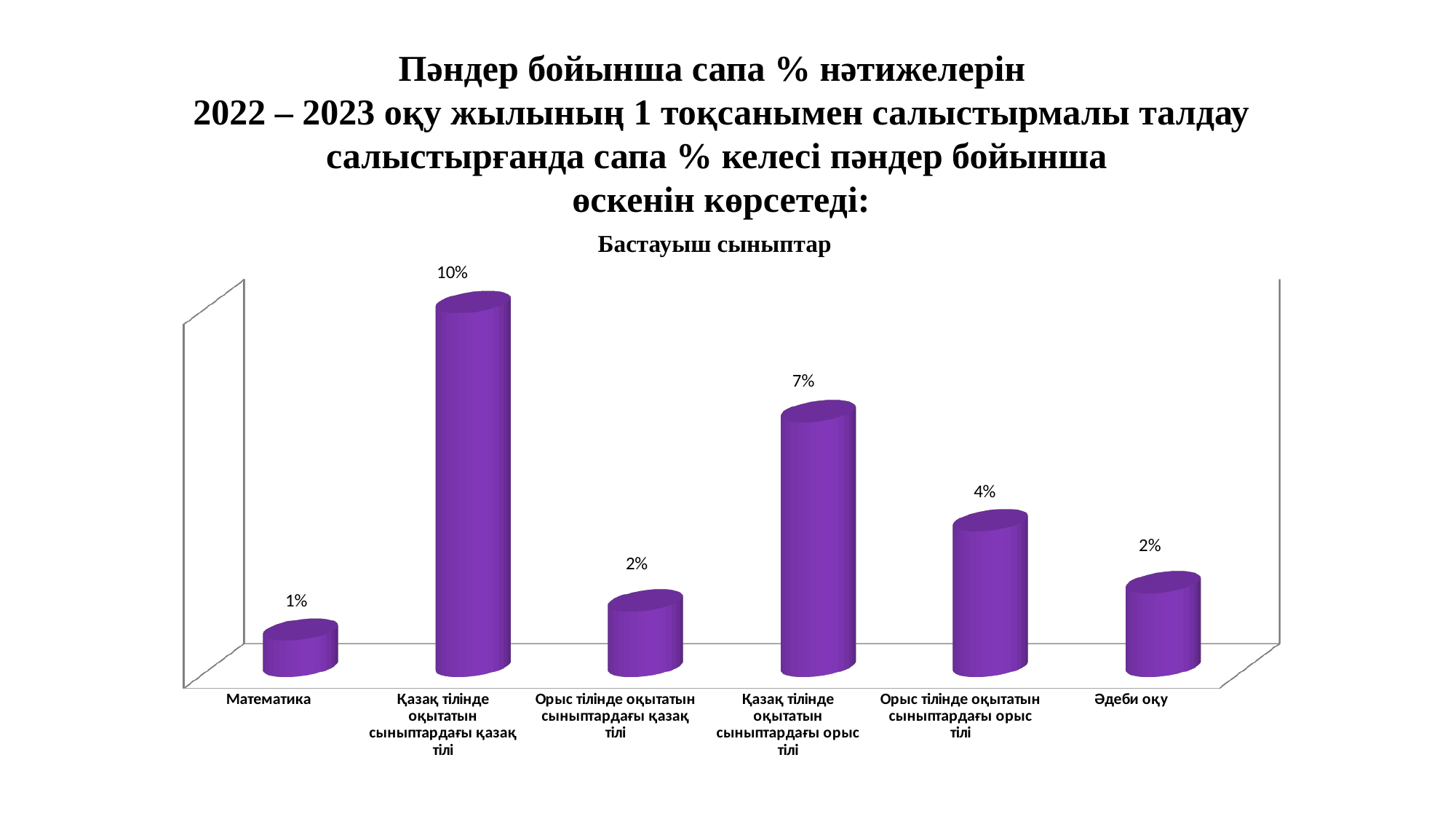
How many categories are shown in the chart? 6 What is the value for Математика? 1% What is the value for Орыс тілінде оқытатын сыныптардағы орыс тілі? 4% Which is larger, the value for Қазақ тілінде оқытатын сыныптардағы орыс тілі or the value for Орыс тілінде оқытатын сыныптардағы орыс тілі? Қазақ тілінде оқытатын сыныптардағы орыс тілі What is the value for Әдеби оқу? 2% Which category has the highest value? Қазақ тілінде оқытатын сыныптардағы қазақ тілі What is the value for Қазақ тілінде оқытатын сыныптардағы қазақ тілі? 10% What is the difference between the values for Қазақ тілінде оқытатын сыныптардағы қазақ тілі and Қазақ тілінде оқытатын сыныптардағы орыс тілі? 3% What kind of chart is shown on the slide? Bar chart What is the difference between the values for Орыс тілінде оқытатын сыныптардағы орыс тілі and Математика? 3% What is the title of the chart? Бастауыш сыныптар Which category has the lowest value? Математика